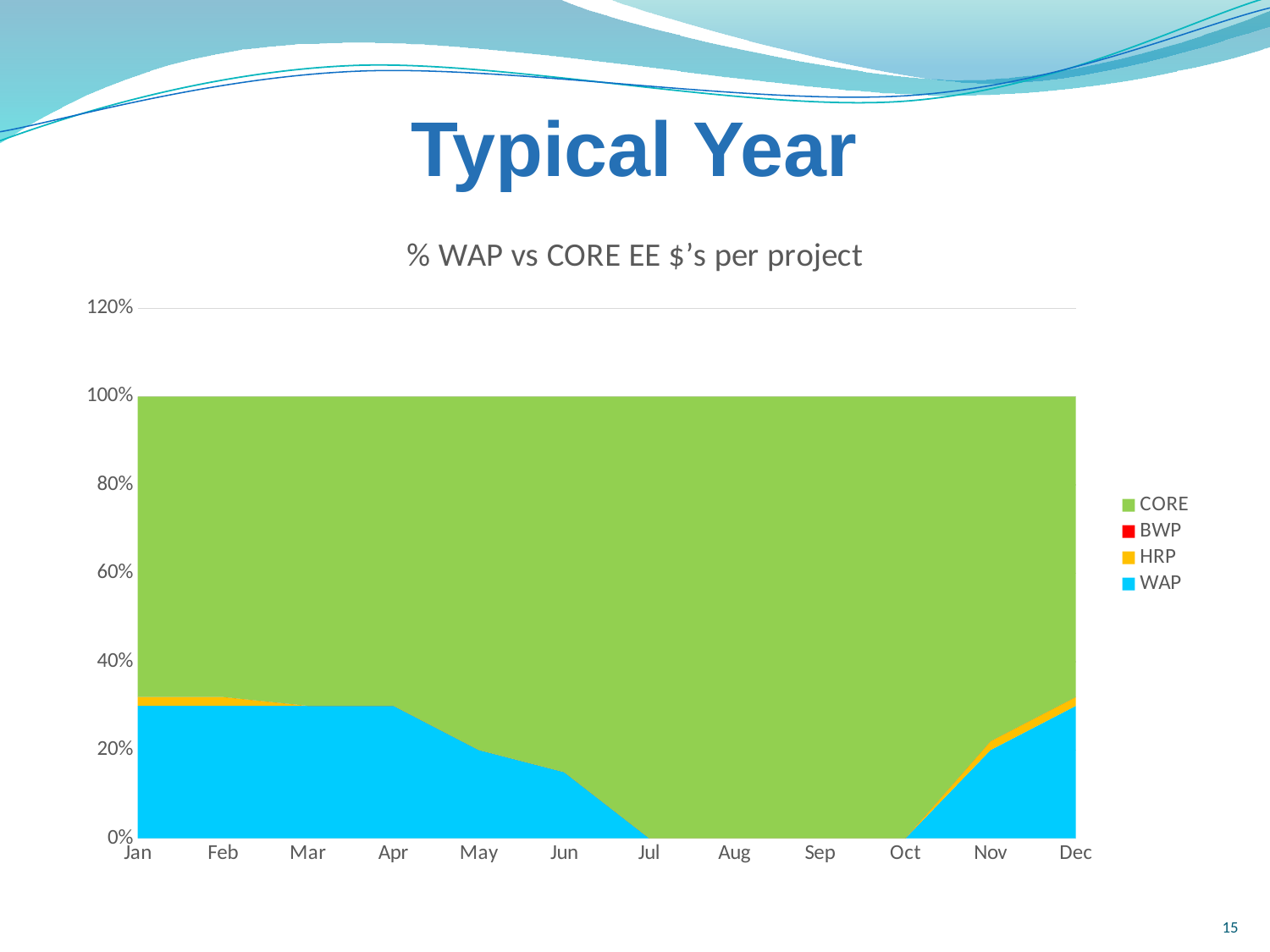
Which month has the larger WAP share, Jan or Jun? Jan Does the WAP share rise or fall from Apr to Jul? fall Does the WAP share rise or fall from Oct to Dec? rise How many months are shown along the x axis? 12 Is the WAP share in Jun greater or less than 20%? less What kind of chart is shown on the slide? area chart Which series is shown in blue in the legend? WAP Is the CORE share in Aug greater or less than 80%? greater Is the WAP share in Jan greater or less than 40%? less What is the title of the chart? % WAP vs CORE EE $'s per project How many series does the legend list? 4